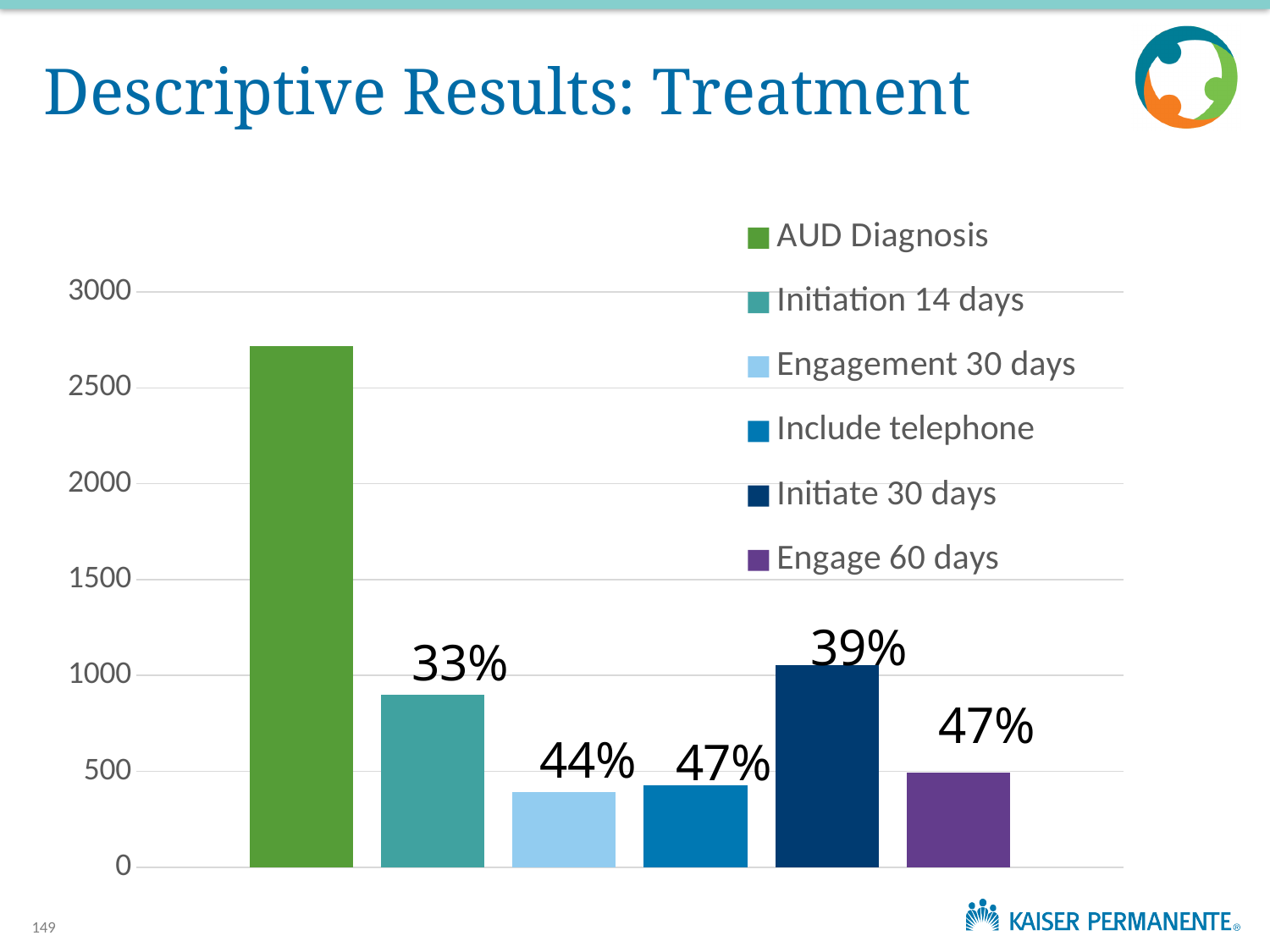
Which series has the tallest bar? AUD Diagnosis Which is larger, the bar for Initiation 14 days or the bar for Initiate 30 days? Initiate 30 days Is the value for AUD Diagnosis greater or less than 2500? greater What percentage label is printed above the Initiation 14 days bar? 33% How many series does the legend list? 6 What is the title of the slide containing the chart? Descriptive Results: Treatment What percentage label is printed above the Initiate 30 days bar? 39% What kind of chart is shown on the slide? bar chart What percentage label is printed above the Engagement 30 days bar? 44% Is the value for Initiation 14 days greater or less than 1000? less How many bars are plotted in the chart? 6 Is the value for Engagement 30 days greater or less than 500? less